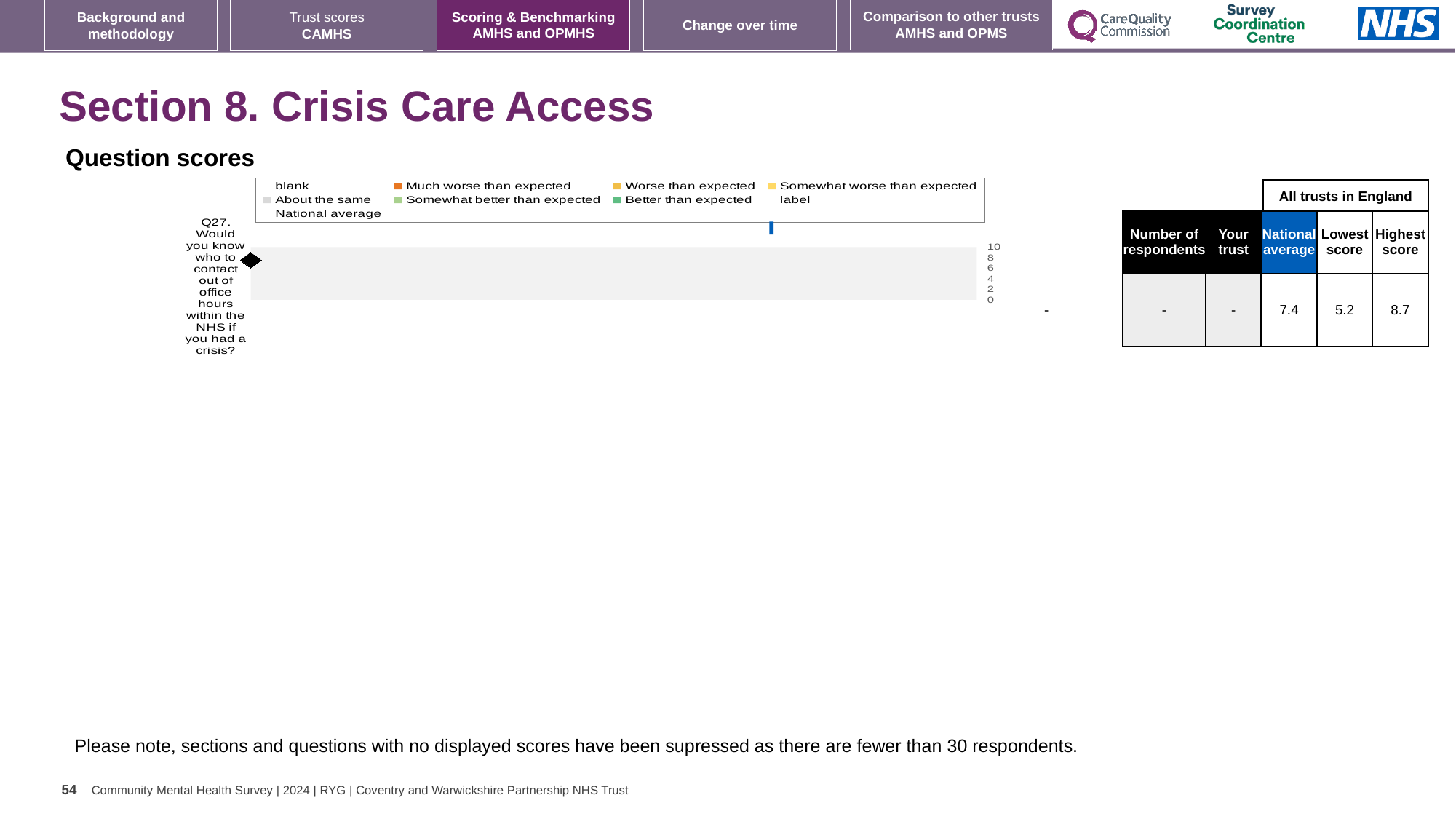
What is the highest value shown on the score axis of the question scores chart? 10 What kind of chart is used for the question scores? bar chart In the table, what is the difference between the highest score and the lowest score for Q27? 3.5 Which question is listed on the question scores chart? Q27. Would you know who to contact out of office hours within the NHS if you had a crisis? In the table, what is the highest score among all trusts in England for Q27? 8.7 How many questions (categories) are plotted in the question scores chart? 1 In the table, what is shown for the number of respondents for Q27? - In the table, what is shown for your trust's score for Q27? - In the table, what is the lowest score among all trusts in England for Q27? 5.2 In the table, which is larger for Q27: the national average or the lowest score? national average In the table, what is the national average score for Q27? 7.4